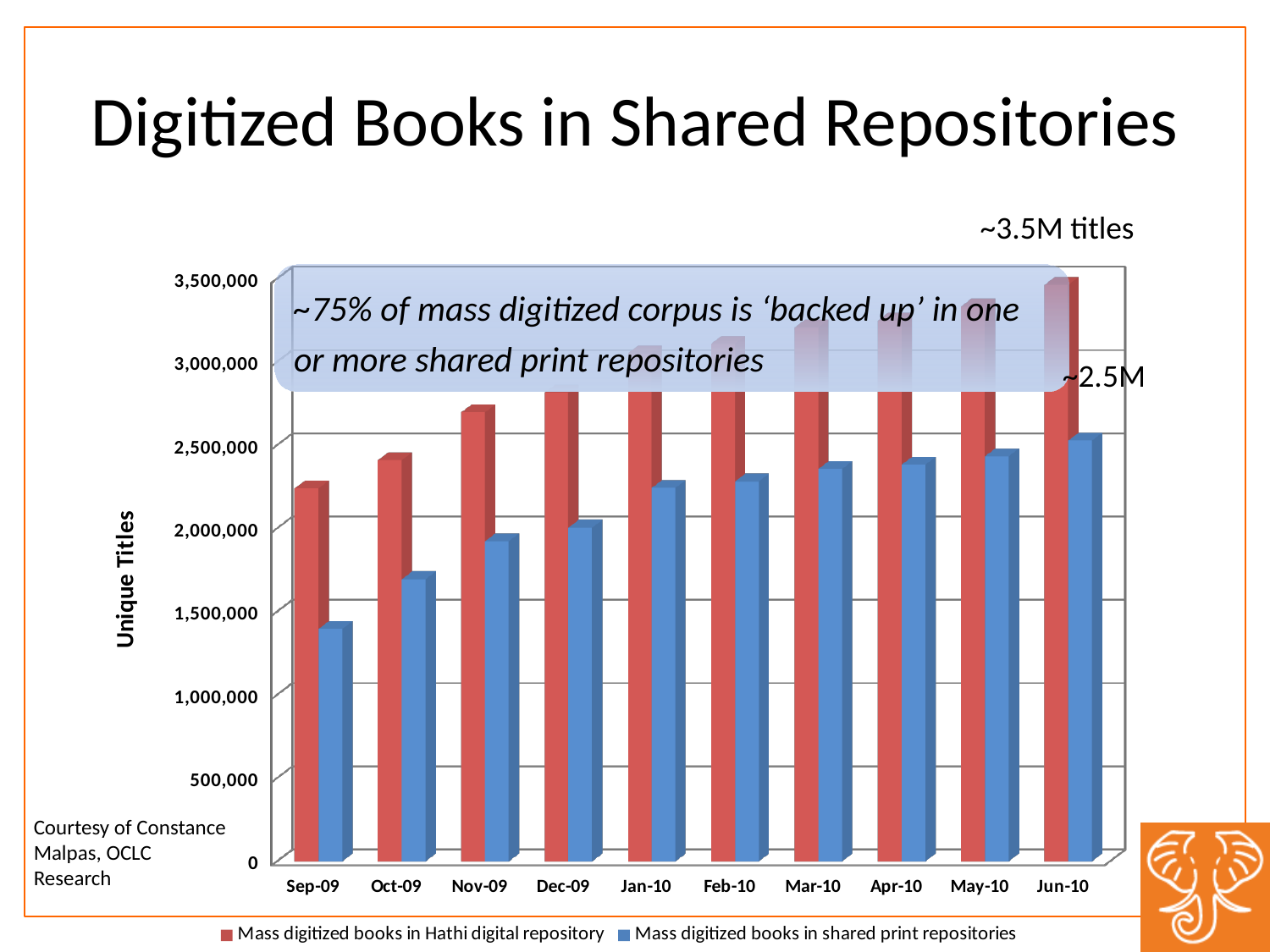
What is the label on the vertical axis of the chart? Unique Titles Is the value for mass digitized books in shared print repositories in Jan-10 greater or less than 2,000,000? greater In Sep-09, which is larger: mass digitized books in Hathi digital repository or mass digitized books in shared print repositories? Mass digitized books in Hathi digital repository Do the values for mass digitized books in shared print repositories rise or fall from Sep-09 to Jun-10? rise Which month has the lowest value for mass digitized books in shared print repositories? Sep-09 How many months are shown along the x axis of the chart? 10 Is the value for mass digitized books in Hathi digital repository in Nov-09 greater or less than 2,500,000? greater Is the value for mass digitized books in Hathi digital repository in Jun-10 greater or less than 3,000,000? greater How many series does the chart's legend list? 2 Which month has the highest value for mass digitized books in Hathi digital repository? Jun-10 What kind of chart is shown on the slide? bar chart